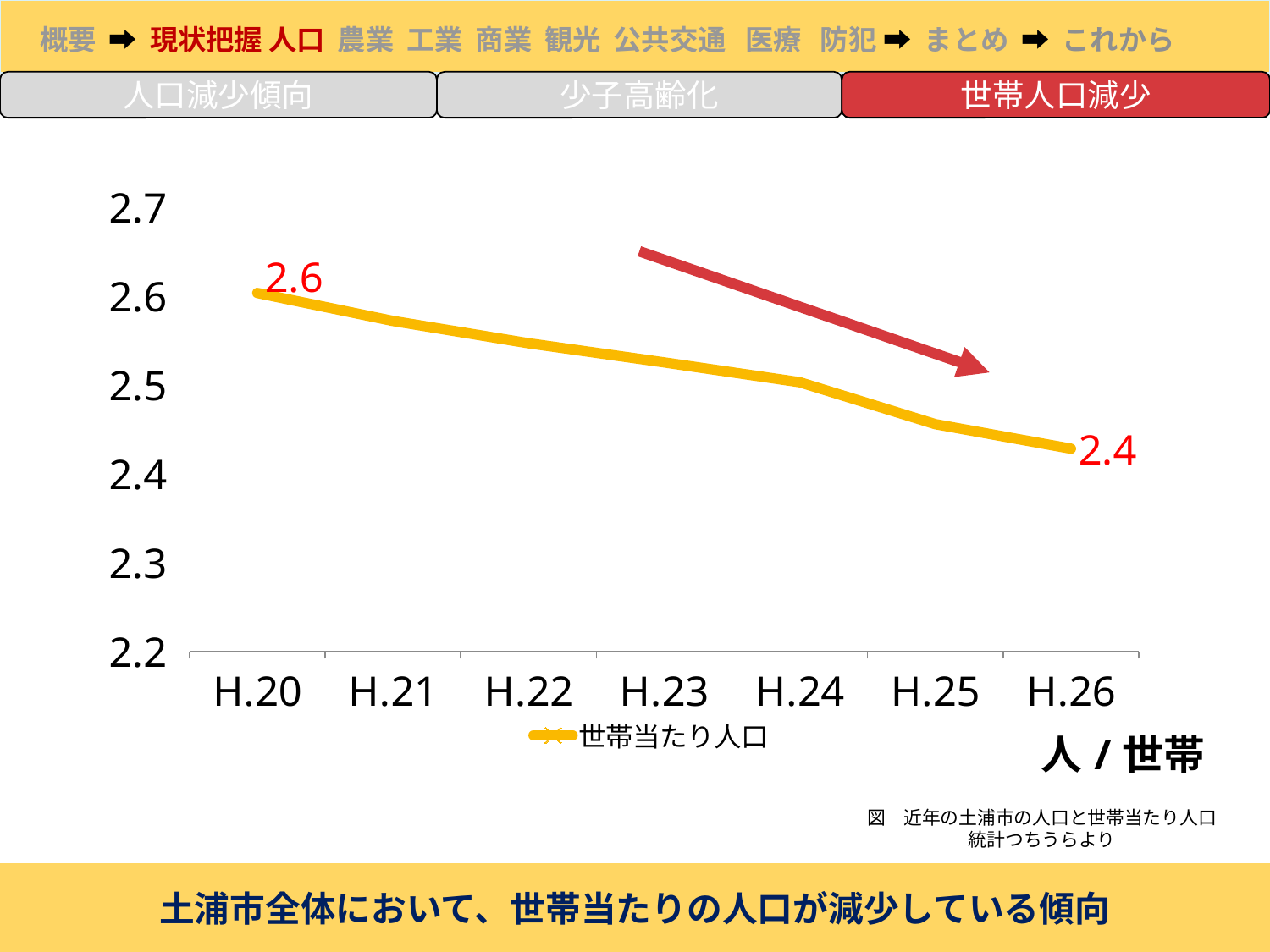
How many years are plotted on the x axis of the chart? 7 Which year has the highest value in the chart? H.20 Which year has the lowest value in the chart? H.26 Is the value for H.25 greater or less than 2.5? less Is the value for H.22 greater or less than 2.5? greater What kind of chart is shown on the slide? line chart Which is larger, the value for H.20 or the value for H.26? H.20 What is the value for H.26 in the 世帯当たり人口 chart? 2.4 How many series does the legend list? 1 What is the value for H.20 in the 世帯当たり人口 chart? 2.6 Do the values rise or fall from H.20 to H.26? fall What is the difference between the values for H.20 and H.26? 0.2